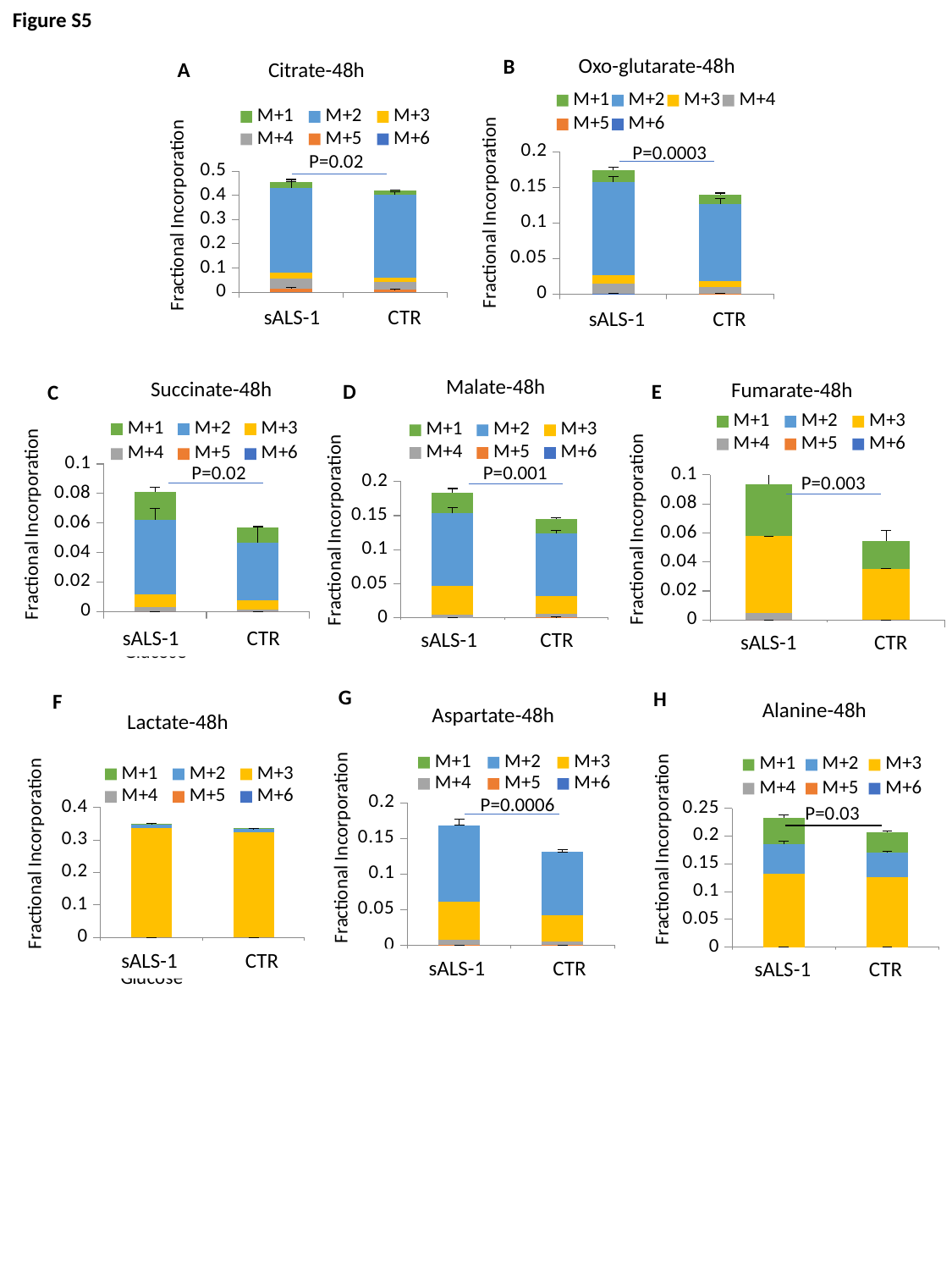
What P value is printed on the Oxo-glutarate-48h chart? P=0.0003 What kind of chart is the Citrate-48h chart? bar chart In the Fumarate-48h chart, which category has the higher total, sALS-1 or CTR? sALS-1 What is the y-axis label of the Alanine-48h chart? Fractional Incorporation In the Oxo-glutarate-48h chart, is the total value for CTR greater or less than 0.15? less In the Oxo-glutarate-48h chart, which category has the taller stacked bar, sALS-1 or CTR? sALS-1 In the Succinate-48h chart, is the total value for sALS-1 greater or less than 0.1? less In the Lactate-48h chart, is the total value for sALS-1 greater or less than 0.4? less How many series does the legend of the Citrate-48h chart list? 6 How many categories are shown on the x axis of the Succinate-48h chart? 2